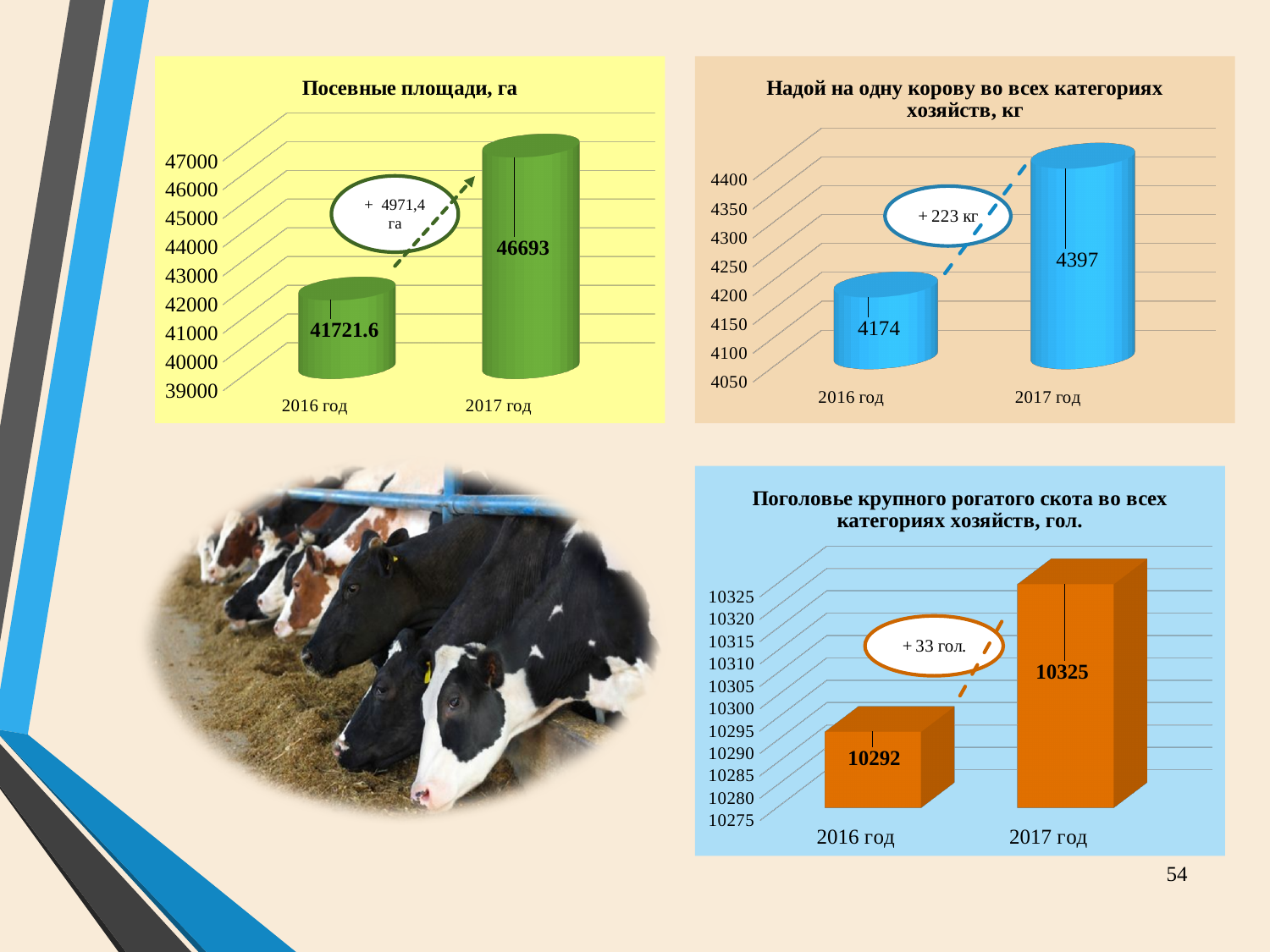
In the chart titled "Посевные площади, га", what is the value for 2017 год? 46693 What kind of chart is the one titled "Поголовье крупного рогатого скота во всех категориях хозяйств, гол."? bar chart In the chart titled "Надой на одну корову во всех категориях хозяйств, кг", by how much does the 2017 год value exceed the 2016 год value? 223 In the chart titled "Посевные площади, га", what is the difference between the 2017 год and 2016 год values? 4971.4 In the chart titled "Поголовье крупного рогатого скота во всех категориях хозяйств, гол.", what is the difference between the 2017 год and 2016 год values? 33 In the chart titled "Поголовье крупного рогатого скота во всех категориях хозяйств, гол.", what is the value for 2017 год? 10325 In the chart titled "Надой на одну корову во всех категориях хозяйств, кг", what is the value for 2017 год? 4397 In the chart titled "Поголовье крупного рогатого скота во всех категориях хозяйств, гол.", what is the value for 2016 год? 10292 In the chart titled "Посевные площади, га", what is the value for 2016 год? 41721.6 In the chart titled "Посевные площади, га", which year has the higher value? 2017 год In the chart titled "Надой на одну корову во всех категориях хозяйств, кг", what is the value for 2016 год? 4174 In the chart titled "Надой на одну корову во всех категориях хозяйств, кг", do the values rise or fall from 2016 год to 2017 год? rise